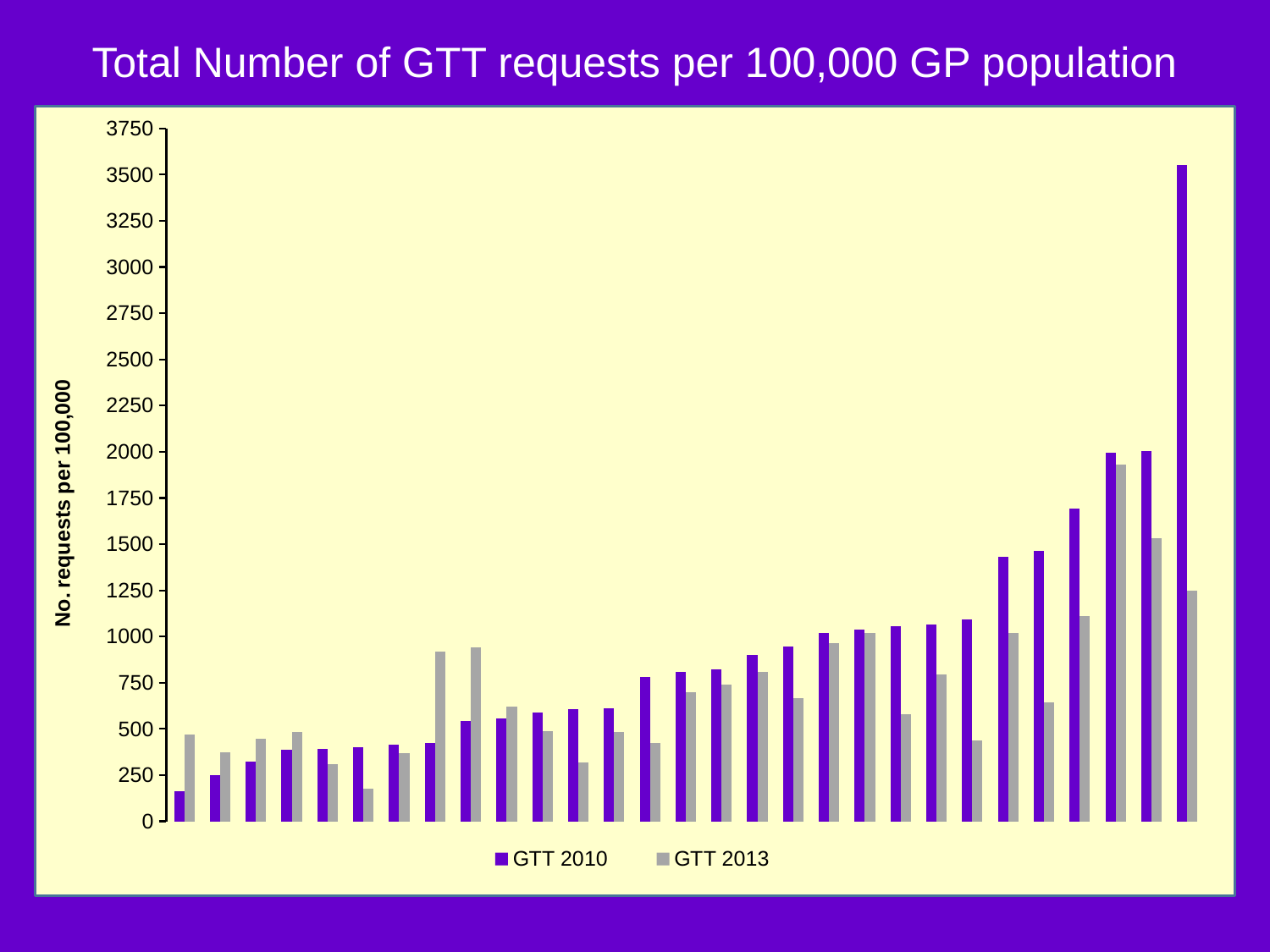
In the leftmost group of bars, which series has the larger value, GTT 2010 or GTT 2013? GTT 2013 How many series does the legend list? 2 In the rightmost group of bars, which series has the larger value, GTT 2010 or GTT 2013? GTT 2010 Is the tallest GTT 2010 bar greater or less than 3250? greater What is the title of the chart? Total Number of GTT requests per 100,000 GP population What is the label on the vertical axis? No. requests per 100,000 Is the leftmost GTT 2010 bar greater or less than 250? less What kind of chart is shown on the slide? bar chart Which series contains the tallest bar on the chart? GTT 2010 Which series is shown in purple? GTT 2010 Do the GTT 2010 values generally rise or fall from left to right along the x axis? rise